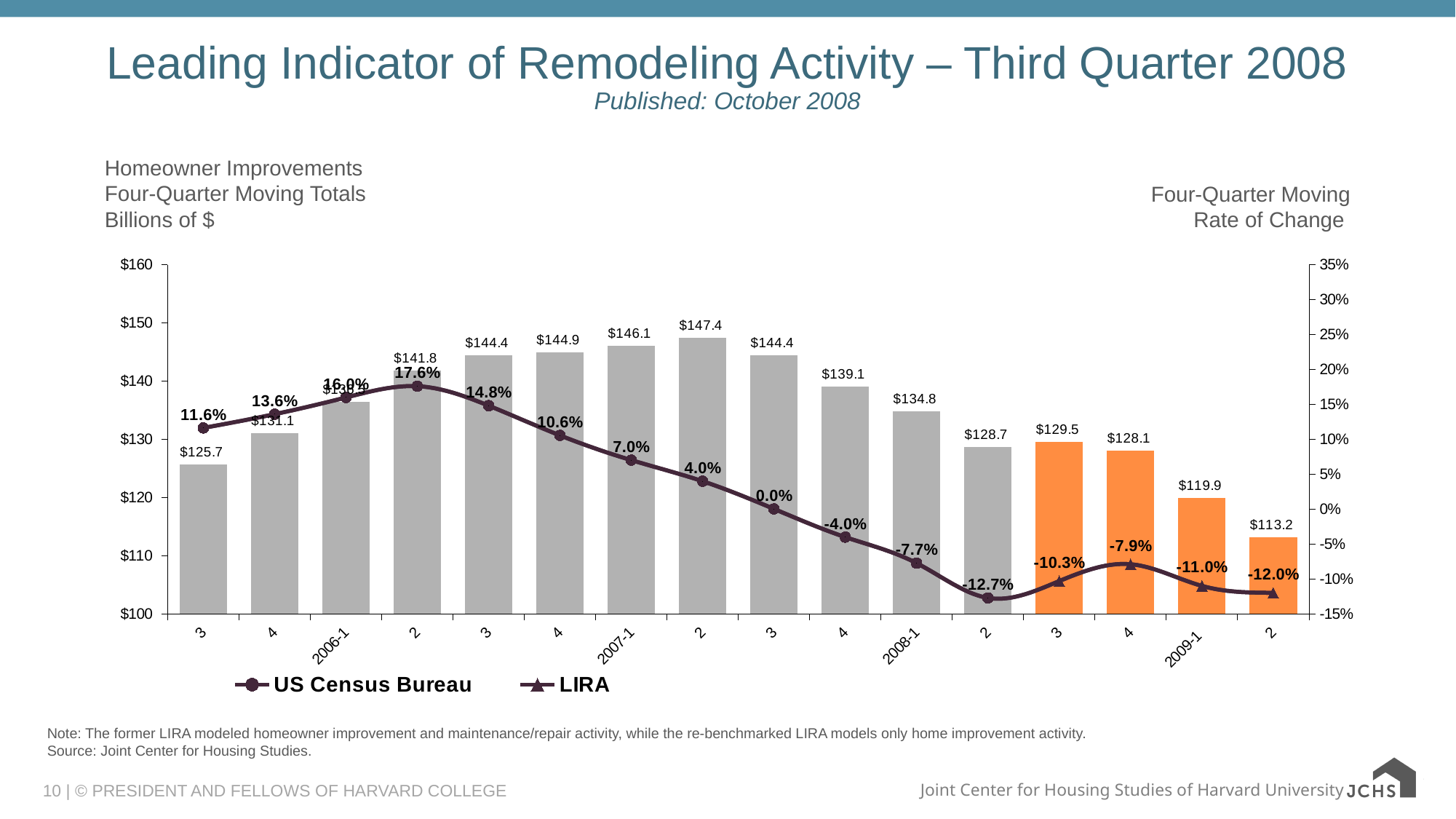
Do the bar values rise or fall from 2007-2 through 2009-2? fall What is the lowest four-quarter moving rate of change plotted on the line? -12.7% What is the four-quarter moving total (bar value) for 2008-1? $134.8 Which quarter has the lowest four-quarter moving total bar? 2009-2 ($113.2) What is the four-quarter moving rate of change shown for 2007-1? 7.0% What is the highest four-quarter moving rate of change plotted on the line? 17.6% How many bars (quarters) are plotted in the chart? 16 How many series does the legend list? 2 Which quarter has the highest four-quarter moving total bar? 2007-2 ($147.4) How many bars are colored orange rather than gray? 4 What is the difference between the highest bar ($147.4) and the lowest bar ($113.2)? $34.2 Which is larger, the bar for 2007-4 or the bar for 2008-1? 2007-4 ($139.1)